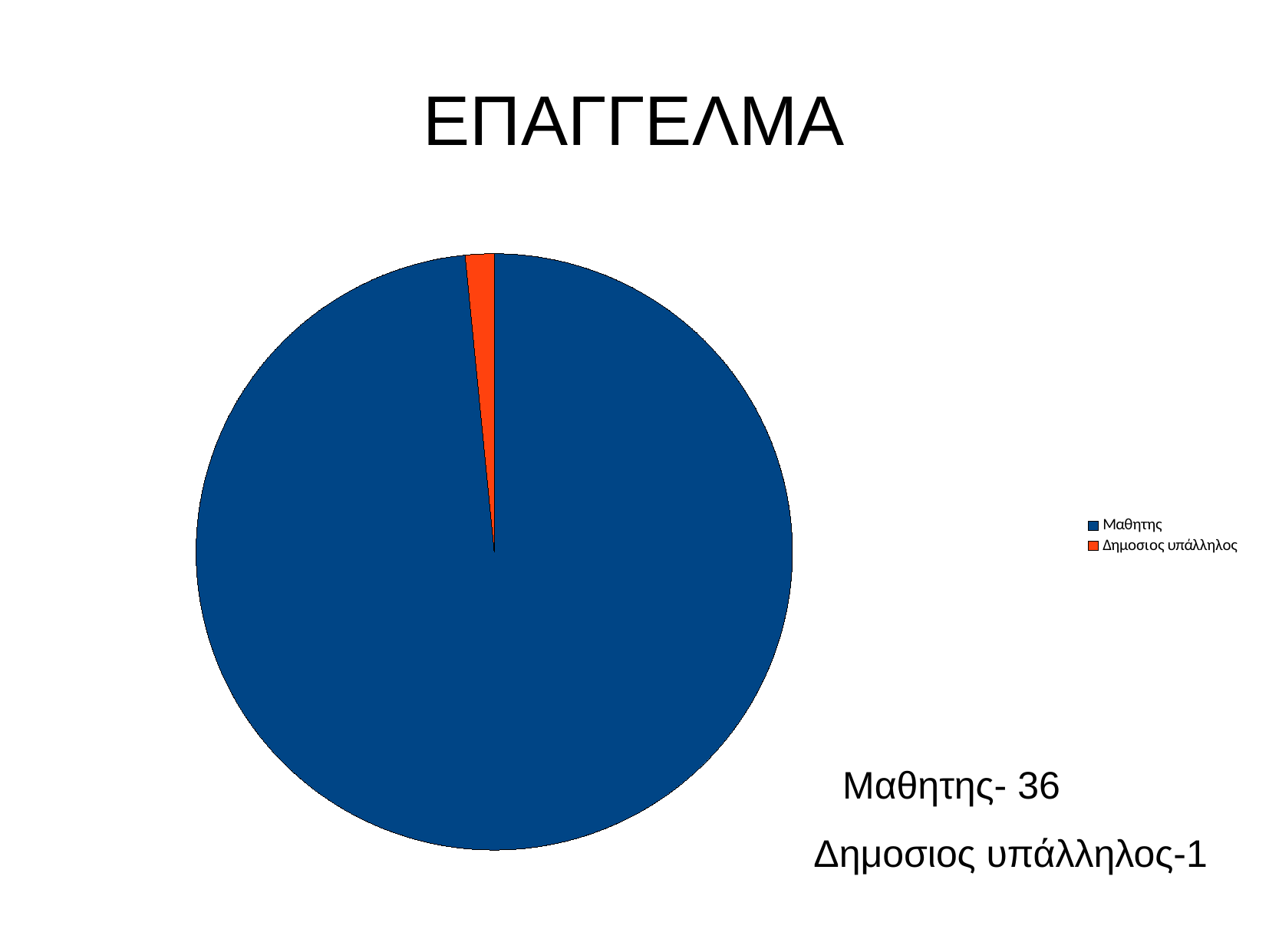
What is the title of the chart? ΕΠΑΓΓΕΛΜΑ Which category has the smallest slice of the pie? Δημοσιος υπάλληλος What is the value for Μαθητης? 36 How many entries does the legend list? 2 Which category has the largest slice of the pie? Μαθητης What is the difference between the values for Μαθητης and Δημοσιος υπάλληλος? 35 What colour is the slice for Δημοσιος υπάλληλος? orange How many categories does the pie chart have? 2 Which is larger, the value for Μαθητης or the value for Δημοσιος υπάλληλος? Μαθητης What type of chart is shown on the slide? pie chart What is the value for Δημοσιος υπάλληλος? 1